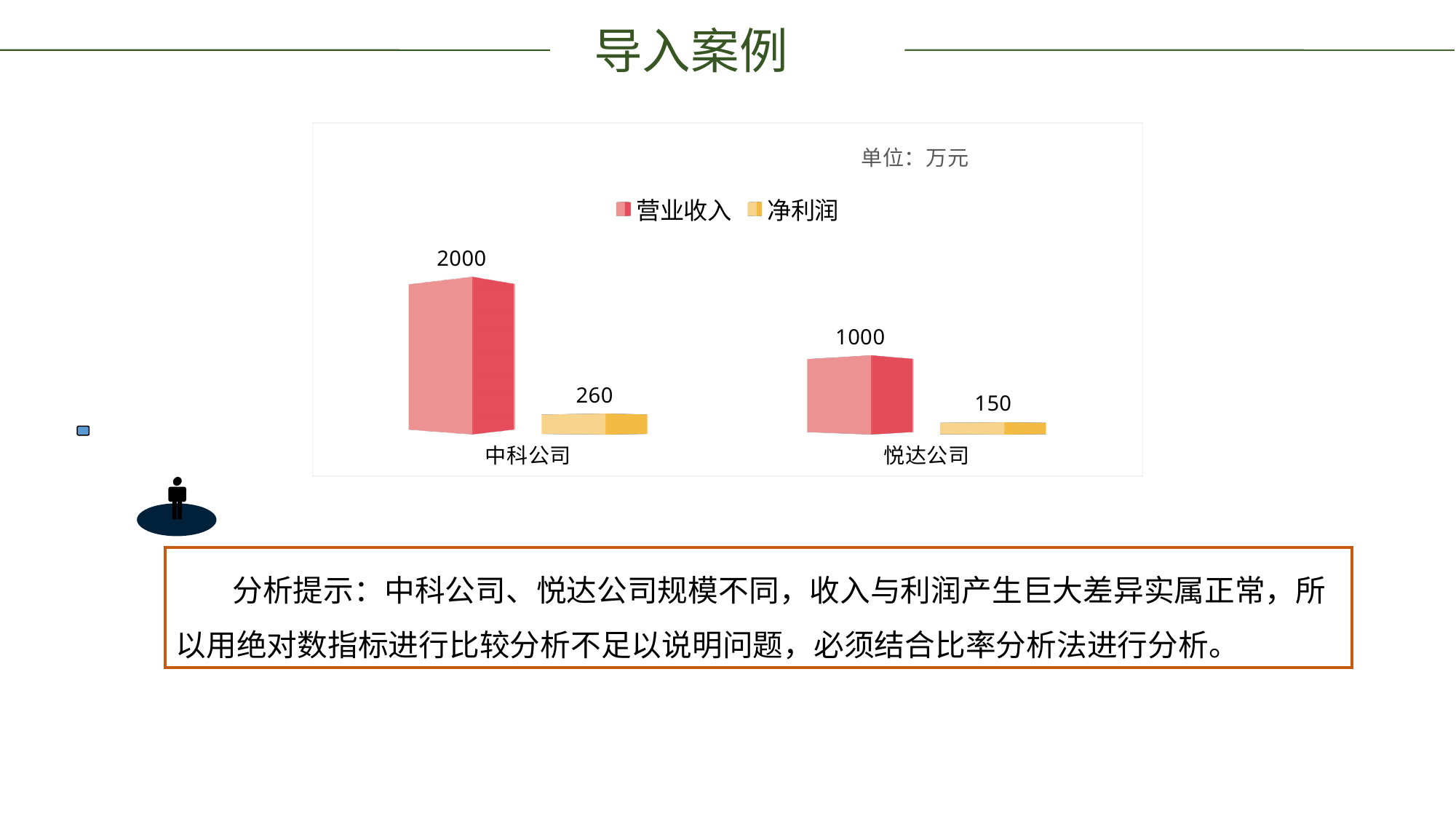
Which company has the higher 营业收入? 中科公司 How many companies are shown on the x axis of the chart? 2 Which is larger: the 净利润 of 中科公司 or the 净利润 of 悦达公司? 中科公司 What is the 营业收入 value for 悦达公司? 1000 How many series does the chart legend list? 2 What is the 净利润 value for 悦达公司? 150 Which company has the lower 净利润? 悦达公司 What is the 净利润 value for 中科公司? 260 What is the difference in 净利润 between 中科公司 and 悦达公司? 110 What kind of chart is shown on the slide? Bar chart What is the difference in 营业收入 between 中科公司 and 悦达公司? 1000 What is the 营业收入 value for 中科公司? 2000